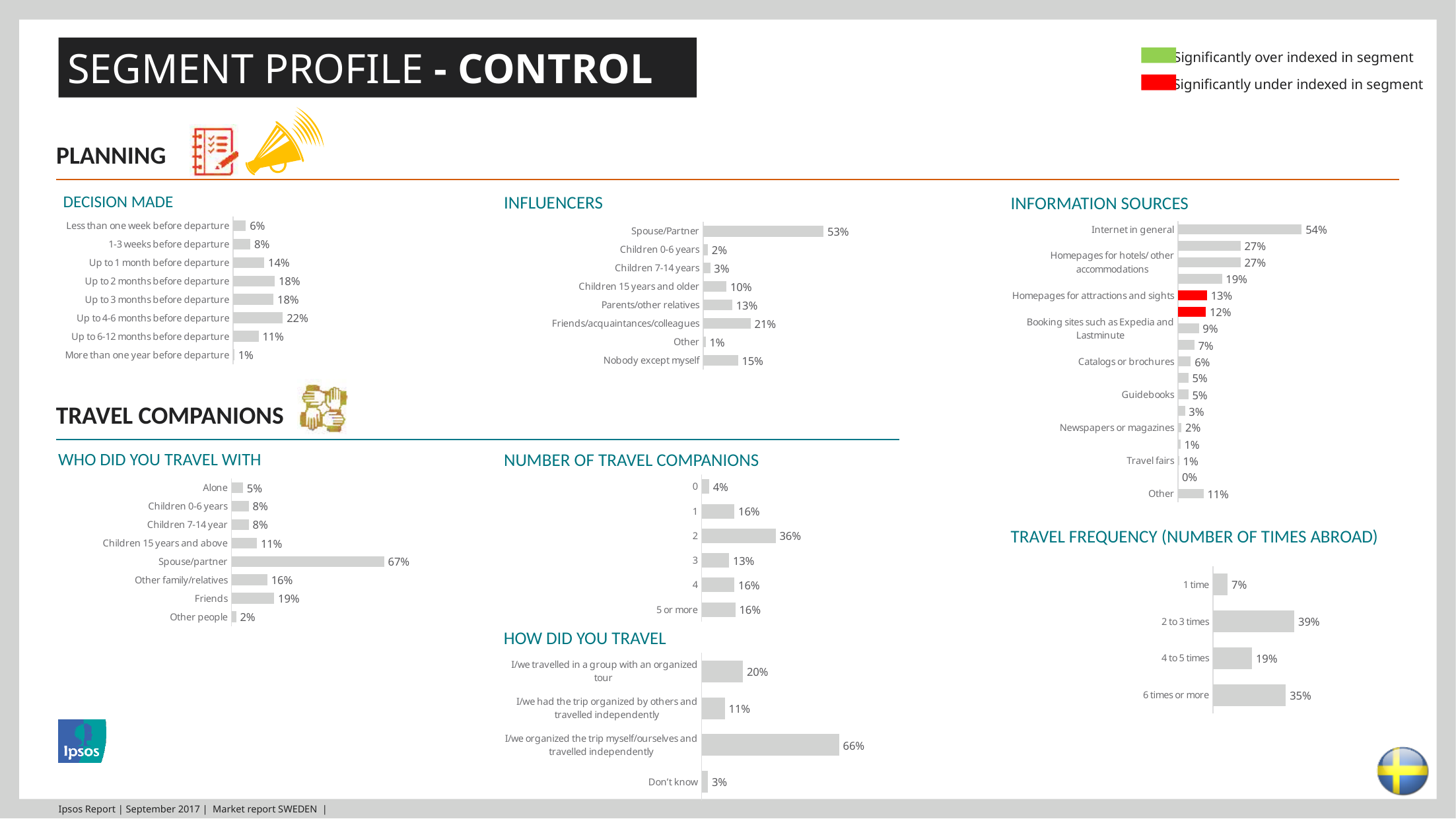
In the NUMBER OF TRAVEL COMPANIONS chart, which category has the highest value? 2 In the INFORMATION SOURCES chart, what is the value for 'Internet in general'? 54% In the WHO DID YOU TRAVEL WITH chart, what is the value for 'Friends'? 19% What type of chart is the TRAVEL FREQUENCY (NUMBER OF TIMES ABROAD) chart? Bar chart In the TRAVEL FREQUENCY (NUMBER OF TIMES ABROAD) chart, what is the difference between '2 to 3 times' and '6 times or more'? 4% In the DECISION MADE chart, which category has the lowest value? More than one year before departure In the HOW DID YOU TRAVEL chart, what is the value for 'I/we organized the trip myself/ourselves and travelled independently'? 66% In the INFORMATION SOURCES chart, which is larger: 'Catalogs or brochures' or 'Other'? Other In the INFLUENCERS chart, what is the difference between 'Friends/acquaintances/colleagues' and 'Parents/other relatives'? 8% In the WHO DID YOU TRAVEL WITH chart, how many categories are shown? 8 In the INFLUENCERS chart, which category has the highest value? Spouse/Partner In the DECISION MADE chart, what is the value for 'Up to 4-6 months before departure'? 22%